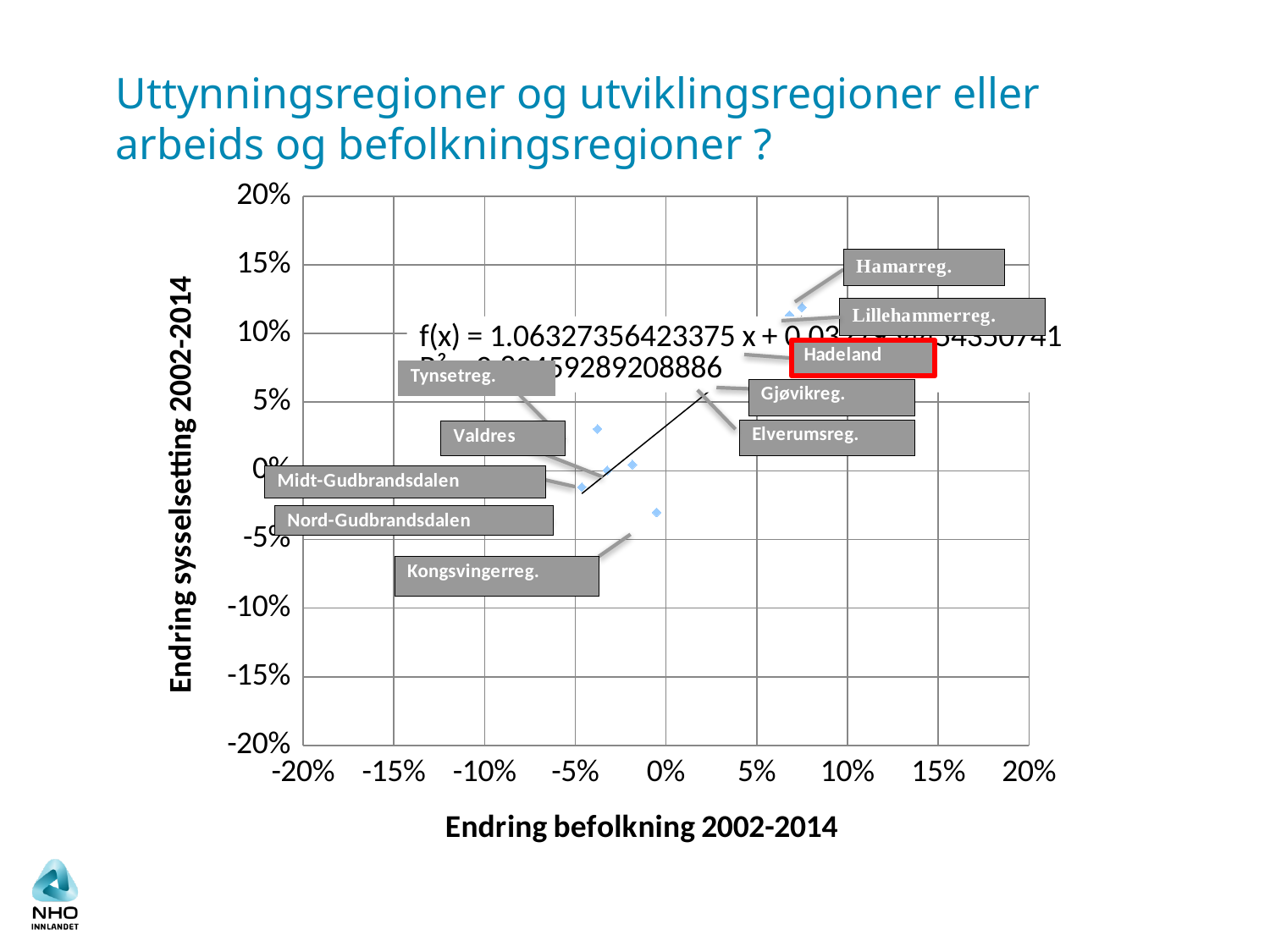
What is the title of the vertical axis of the chart? Endring sysselsetting 2002-2014 Which region's label is highlighted with a red box on the chart? Hadeland Is the population change (horizontal axis) for Hamarreg. greater or less than 5%? greater How many regions are labelled on the chart? 10 Which region has a higher employment change, Hamarreg. or Kongsvingerreg.? Hamarreg. What kind of chart is shown on the slide? Scatter chart What is the title of the horizontal axis of the chart? Endring befolkning 2002-2014 Is the employment change (vertical axis) for Kongsvingerreg. greater or less than 0%? less Does the trendline on the chart rise or fall as population change increases along the x axis? Rises Is the employment change (vertical axis) for Hamarreg. greater or less than 10%? greater What is the slope (coefficient of x) in the trendline equation shown on the chart? 1.06327356423375 What is the maximum value shown on the vertical axis of the chart? 20%